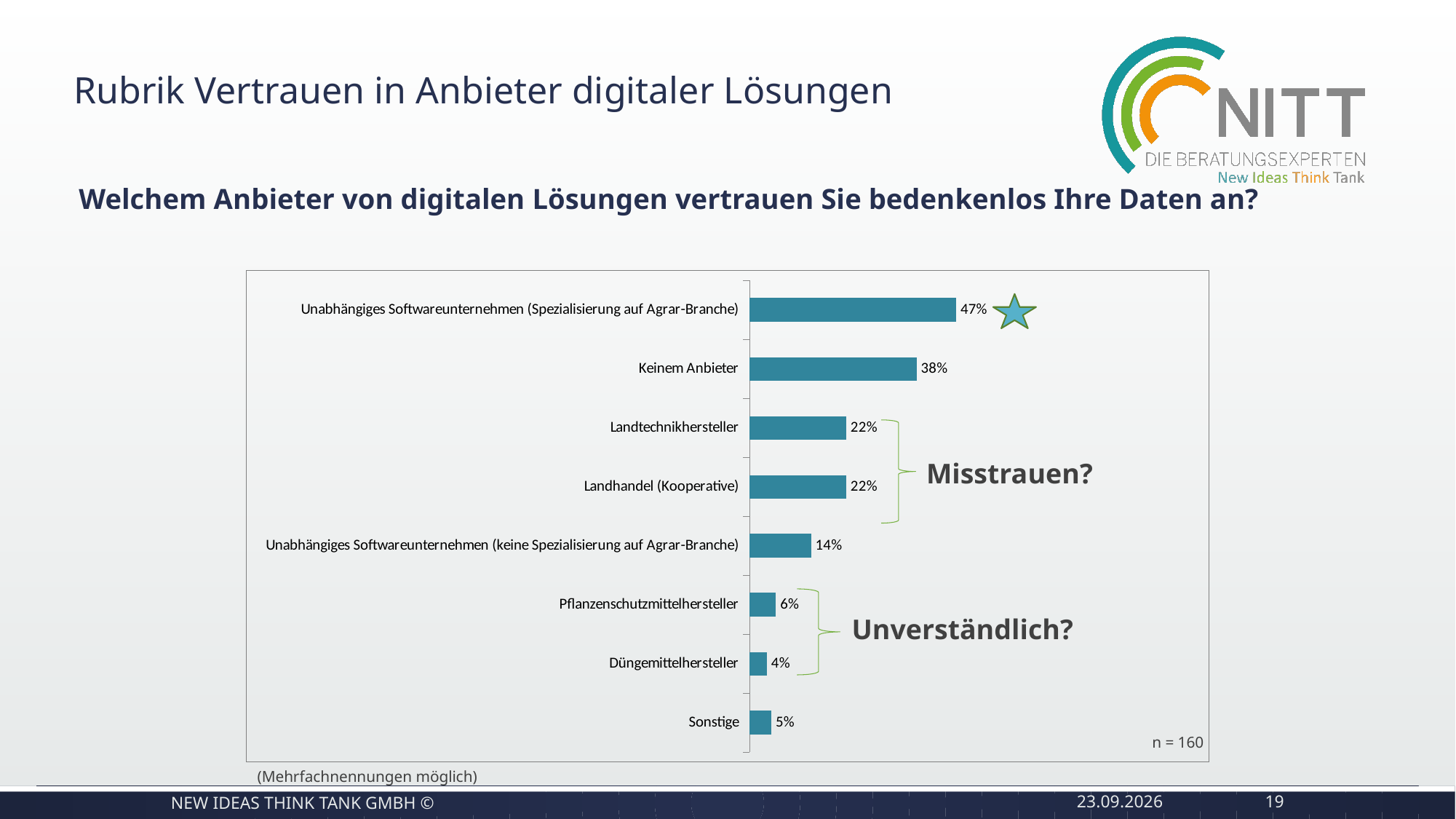
What is the difference between the values for 'Unabhängiges Softwareunternehmen (Spezialisierung auf Agrar-Branche)' and 'Keinem Anbieter'? 9 percentage points What percentage is shown for 'Düngemittelhersteller'? 4% Which category has the lowest value in the chart? Düngemittelhersteller What sample size (n) is stated on the chart? n = 160 Which is larger: the value for 'Pflanzenschutzmittelhersteller' or for 'Sonstige'? Pflanzenschutzmittelhersteller Which annotation label is placed next to the bars for 'Pflanzenschutzmittelhersteller' and 'Düngemittelhersteller'? Unverständlich? What kind of chart is shown on the slide? Bar chart What is the value shown for 'Keinem Anbieter'? 38% Which two categories both have a value of 22%? Landtechnikhersteller and Landhandel (Kooperative) How many categories are shown in the chart? 8 Which category has the highest value in the chart? Unabhängiges Softwareunternehmen (Spezialisierung auf Agrar-Branche) What percentage of respondents trust an independent software company specialised in the agricultural sector (Unabhängiges Softwareunternehmen (Spezialisierung auf Agrar-Branche)) with their data? 47%